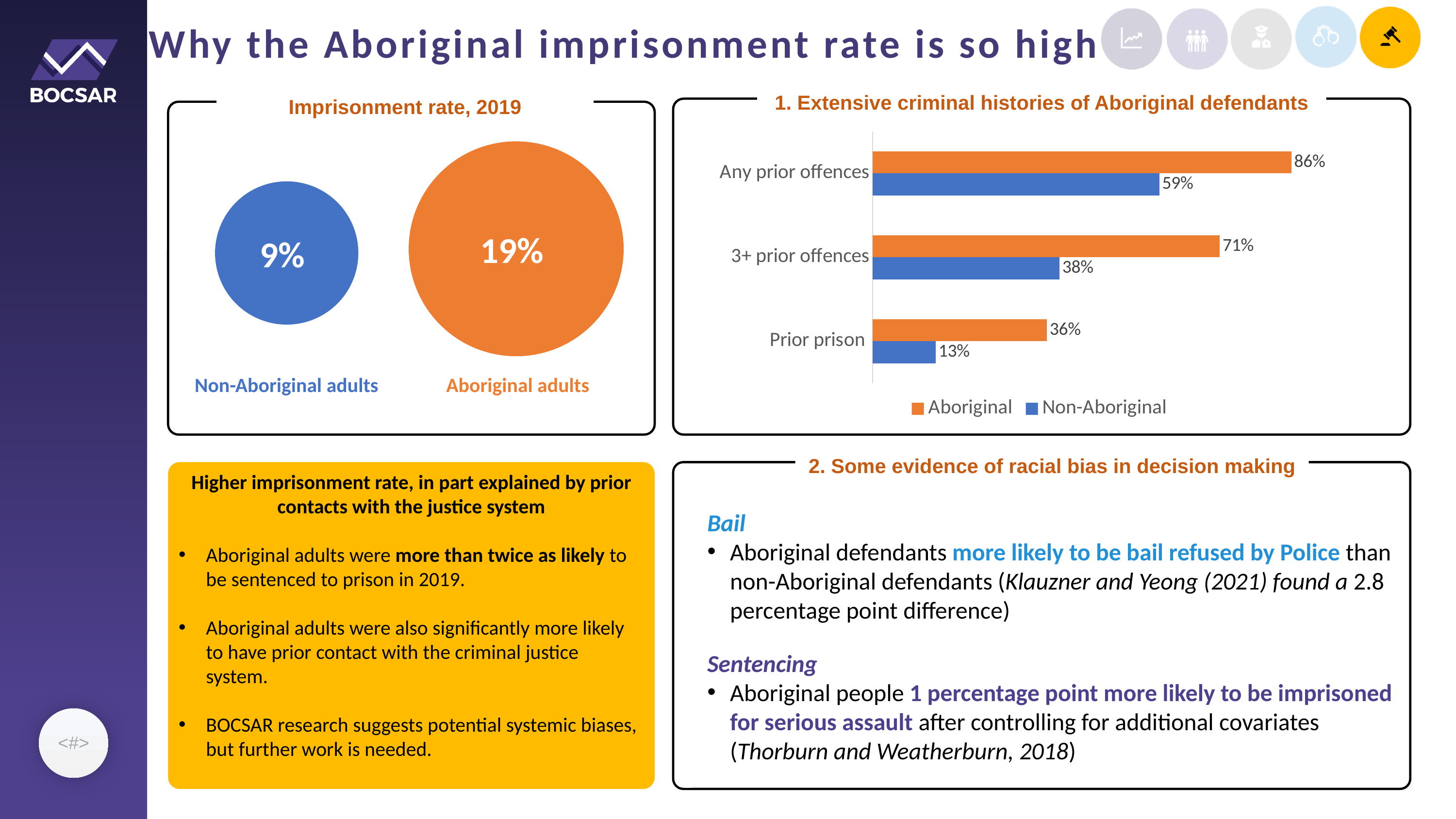
In the 'Extensive criminal histories of Aboriginal defendants' chart, what is the value for Non-Aboriginal defendants with prior prison? 13% In the 'Extensive criminal histories of Aboriginal defendants' chart, which category has the lowest value for the Aboriginal series? Prior prison In the 'Imprisonment rate, 2019' chart, what is the imprisonment rate for Aboriginal adults? 19% In the 'Extensive criminal histories of Aboriginal defendants' chart, what is the value for Aboriginal defendants with any prior offences? 86% What kind of chart is the 'Extensive criminal histories of Aboriginal defendants' chart? Bar chart How many categories are shown in the 'Extensive criminal histories of Aboriginal defendants' chart? 3 In the 'Imprisonment rate, 2019' chart, what is the difference between the rates for Aboriginal adults and Non-Aboriginal adults? 10 percentage points In the 'Extensive criminal histories of Aboriginal defendants' chart, what is the value for Non-Aboriginal defendants with 3+ prior offences? 38% In the 'Extensive criminal histories of Aboriginal defendants' chart, which series has the larger value for prior prison, Aboriginal or Non-Aboriginal? Aboriginal How many series does the legend of the 'Extensive criminal histories of Aboriginal defendants' chart list? 2 In the 'Extensive criminal histories of Aboriginal defendants' chart, which category has the highest value for the Non-Aboriginal series? Any prior offences In the 'Extensive criminal histories of Aboriginal defendants' chart, what is the difference between the Aboriginal and Non-Aboriginal values for 3+ prior offences? 33 percentage points